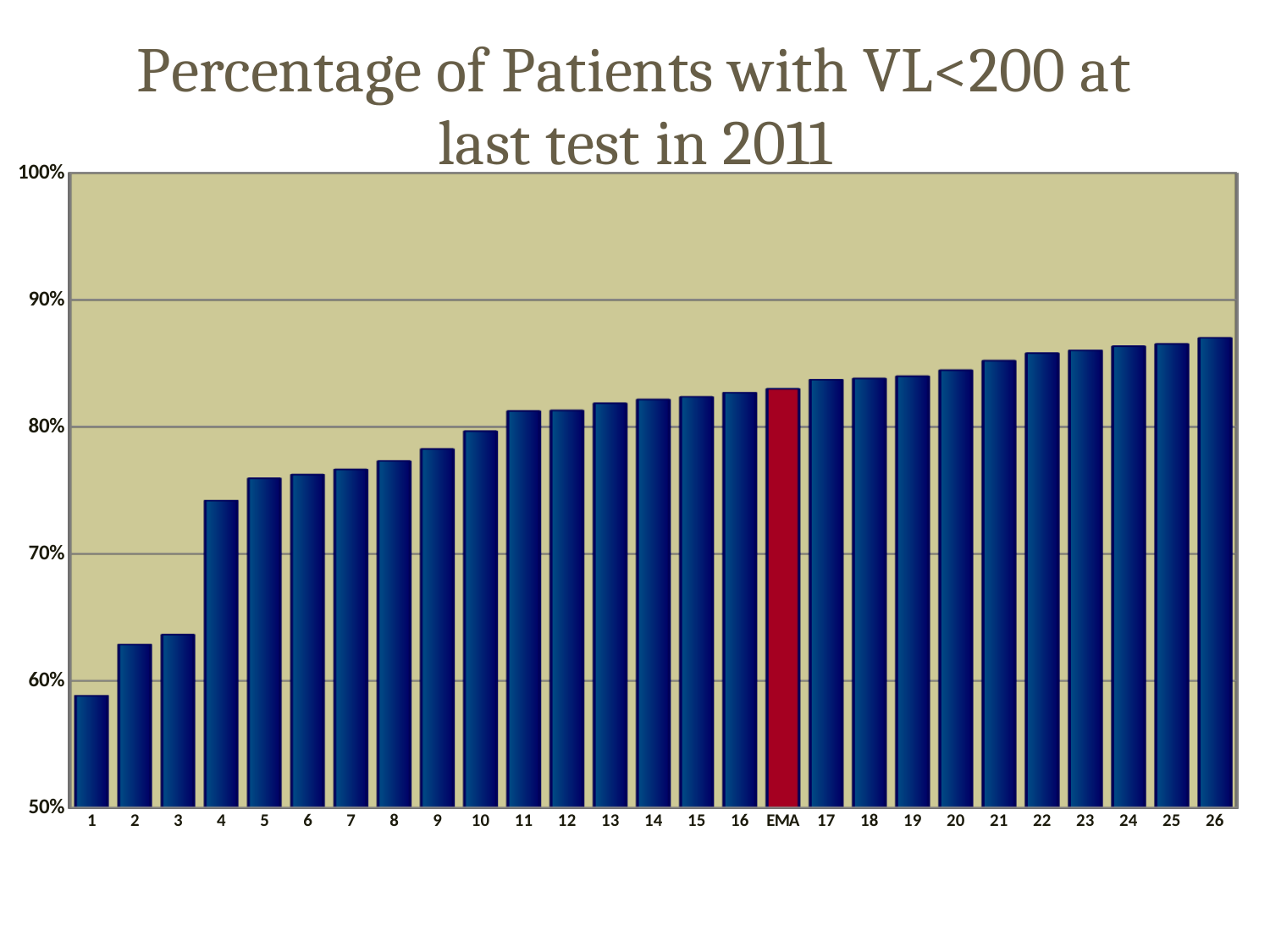
Is the value for EMA greater or less than 80%? greater Which category has the lowest percentage of patients with VL<200? 1 Which bar is coloured red instead of blue? EMA Is the value for category 4 greater or less than 70%? greater Is the value for category 1 greater or less than 60%? less Which has a higher value, category 3 or category 4? 4 What kind of chart is shown on the slide? bar chart How many bars are plotted on the chart? 27 Which category has the highest percentage of patients with VL<200? 26 Do the values rise or fall moving from left to right along the x axis? rise